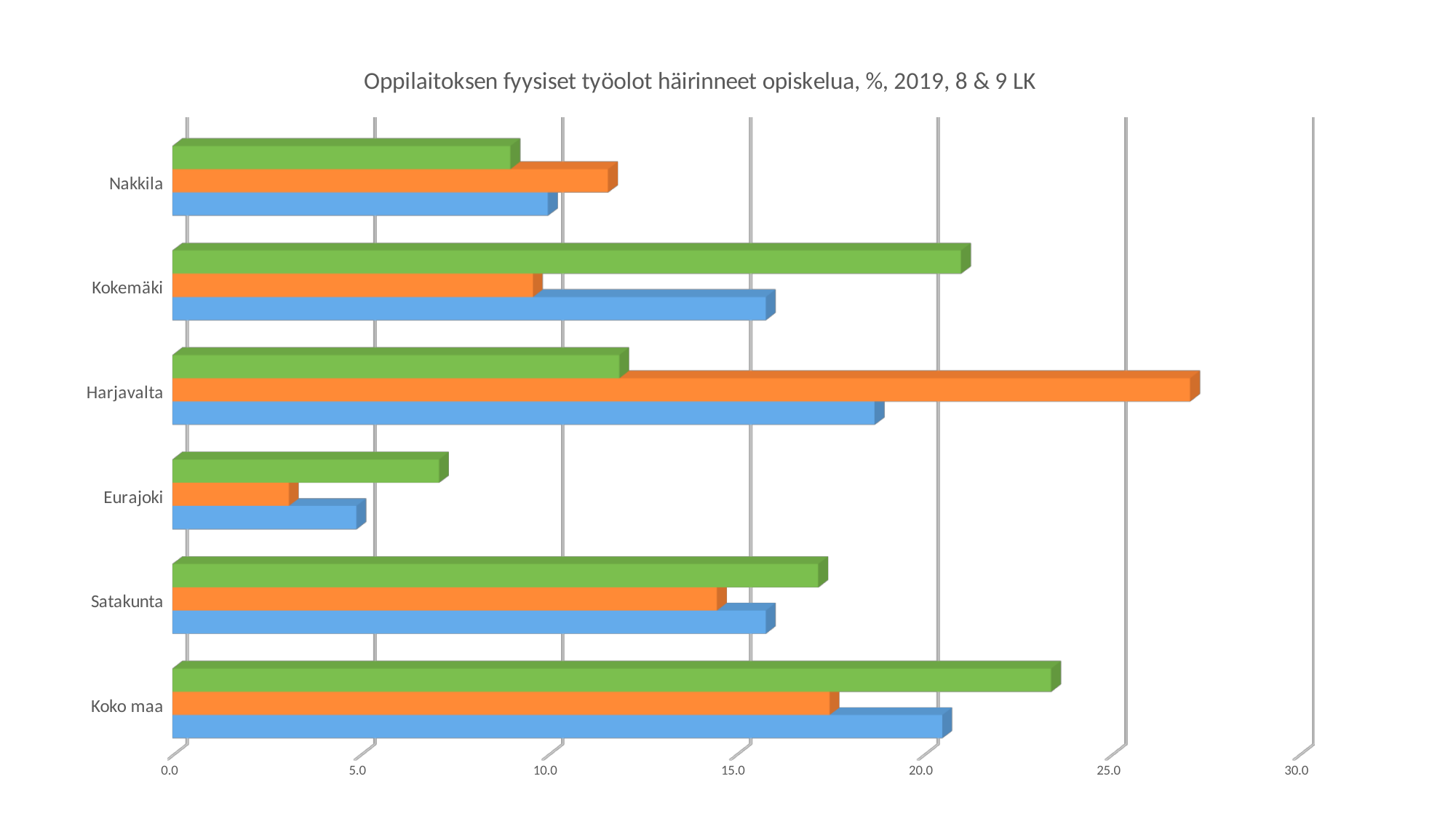
Which category has the shortest green bar? Eurajoki How many categories are shown on the vertical axis of the chart? 6 Which category has the longest orange bar? Harjavalta Which category has the longest green bar? Koko maa What kind of chart is shown on the slide? bar chart What is the title of the chart? Oppilaitoksen fyysiset työolot häirinneet opiskelua, %, 2019, 8 & 9 LK Is the orange bar for Eurajoki greater or less than 5.0? less Which category has the shortest orange bar? Eurajoki Is the orange bar for Harjavalta greater or less than 25.0? greater For Kokemäki, which is larger: the green bar or the orange bar? the green bar Is the green bar for Satakunta greater or less than 15.0? greater How many bars are plotted for each category in the chart? 3